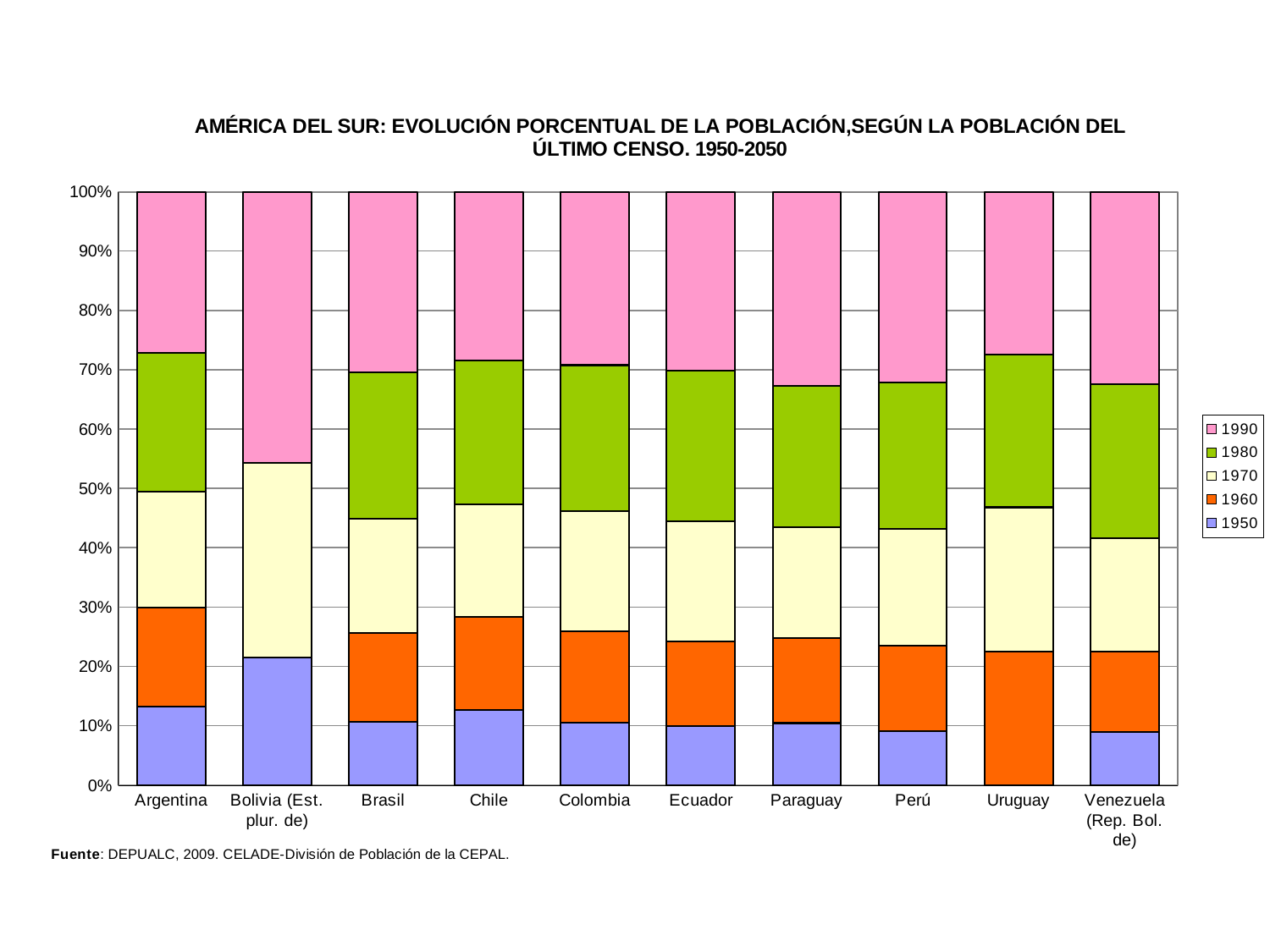
Which is larger, the 1950 segment for Argentina or the 1950 segment for Brasil? Argentina Is the top of the 1950 segment for Argentina greater or less than 10%? greater Which country has the largest 1990 segment? Bolivia (Est. plur. de) Which country has the largest 1950 segment? Bolivia (Est. plur. de) Which country has the largest 1960 segment? Uruguay What is the total of the stacked bar for Argentina? 100% Which country shows no 1960 segment in its bar? Bolivia (Est. plur. de) How many series does the legend list? 5 What kind of chart is shown on the slide? Stacked bar chart Is the top of the 1950 segment for Bolivia (Est. plur. de) greater or less than 20%? greater How many countries are shown along the x axis? 10 Is the top of the 1980 segment for Uruguay greater or less than 70%? greater